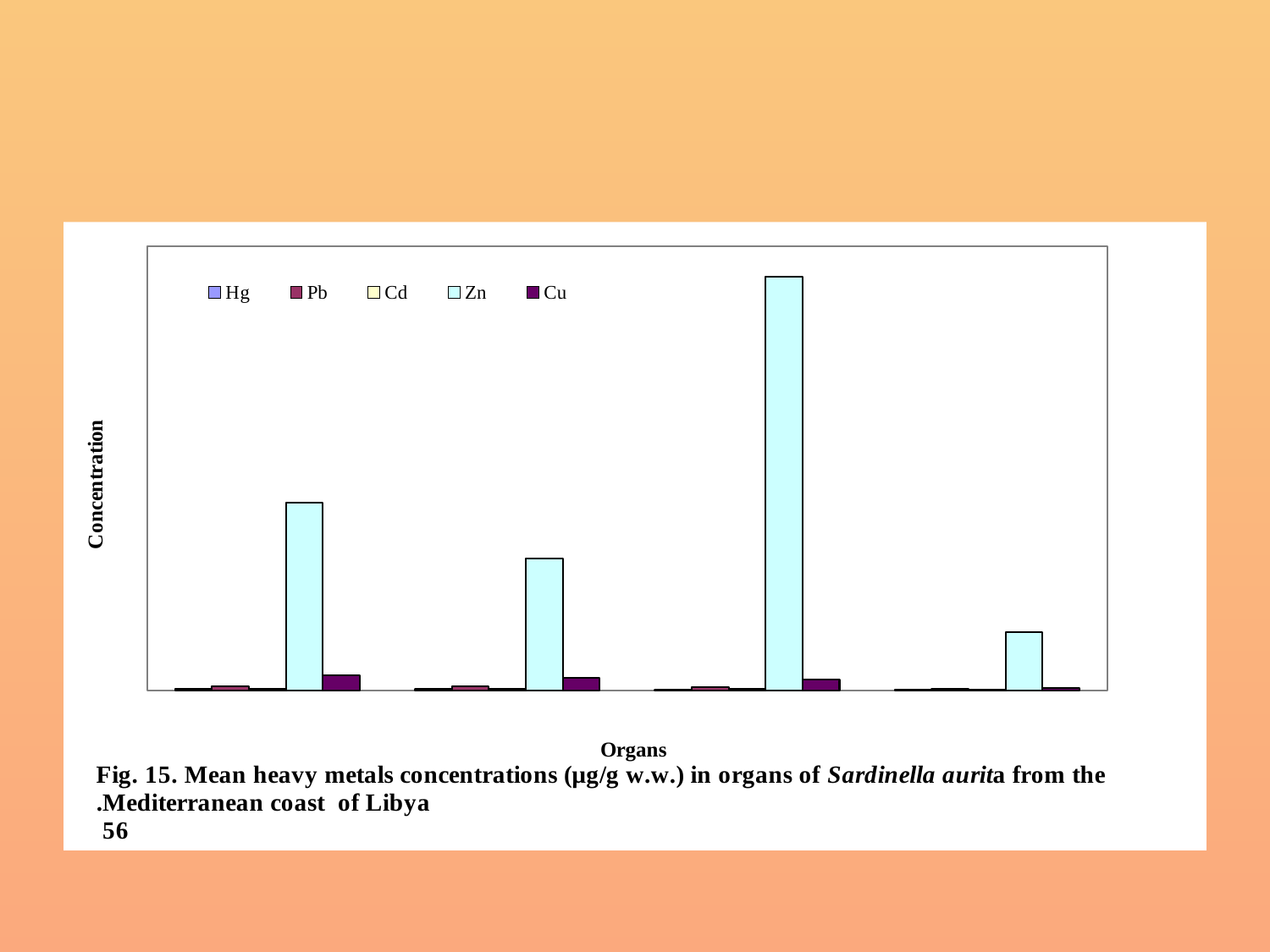
In which group of bars, counting from the left, is the Zn bar the tallest? the third group What is the label of the y axis? Concentration What kind of chart is shown on the slide? bar chart Which is taller, the Zn bar in the first group from the left or the Zn bar in the second group from the left? the first group Which metal has the tallest bars in every group? Zn Which metals are listed in the legend? Hg, Pb, Cd, Zn, Cu After Zn, which metal has the second tallest bars in the groups? Cu How many groups of bars (organs) are plotted along the x axis? 4 In the first group of bars from the left, which is larger, the Zn bar or the Cu bar? Zn How many series does the legend list? 5 In which group of bars, counting from the left, is the Zn bar the shortest? the fourth group What is the label of the x axis? Organs